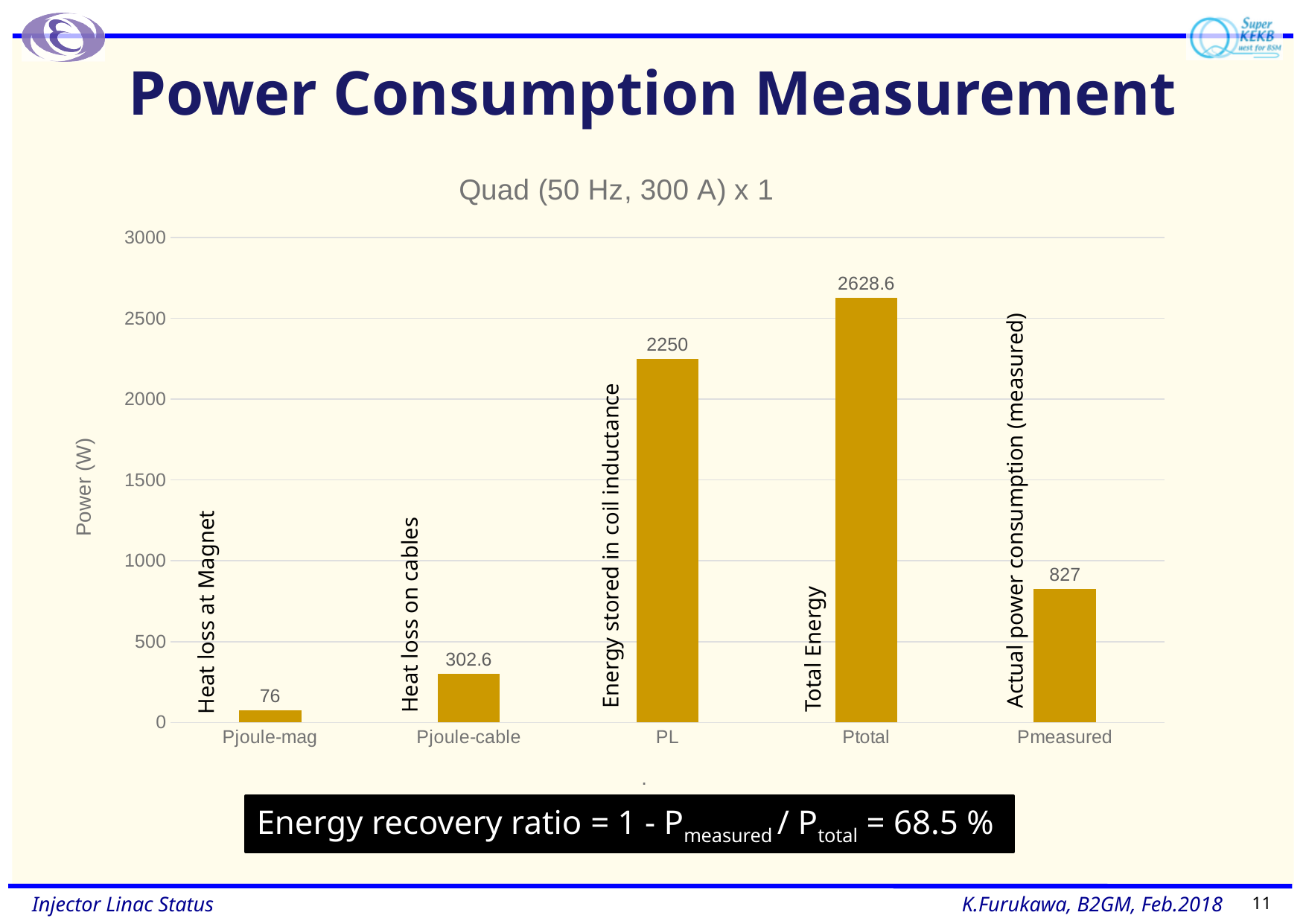
What is the title of the chart? Quad (50 Hz, 300 A) x 1 What is the difference between Ptotal and Pmeasured? 1801.6 What is the difference between Pjoule-cable and Pjoule-mag? 226.6 What is the value for Ptotal? 2628.6 Which is larger, PL or Pmeasured? PL Which category has the lowest value? Pjoule-mag What is the value for Pmeasured? 827 What kind of chart is shown? bar chart Is the value for PL greater or less than 2000? greater How many categories are shown on the x axis? 5 Which category has the highest value? Ptotal What is the value for Pjoule-cable? 302.6